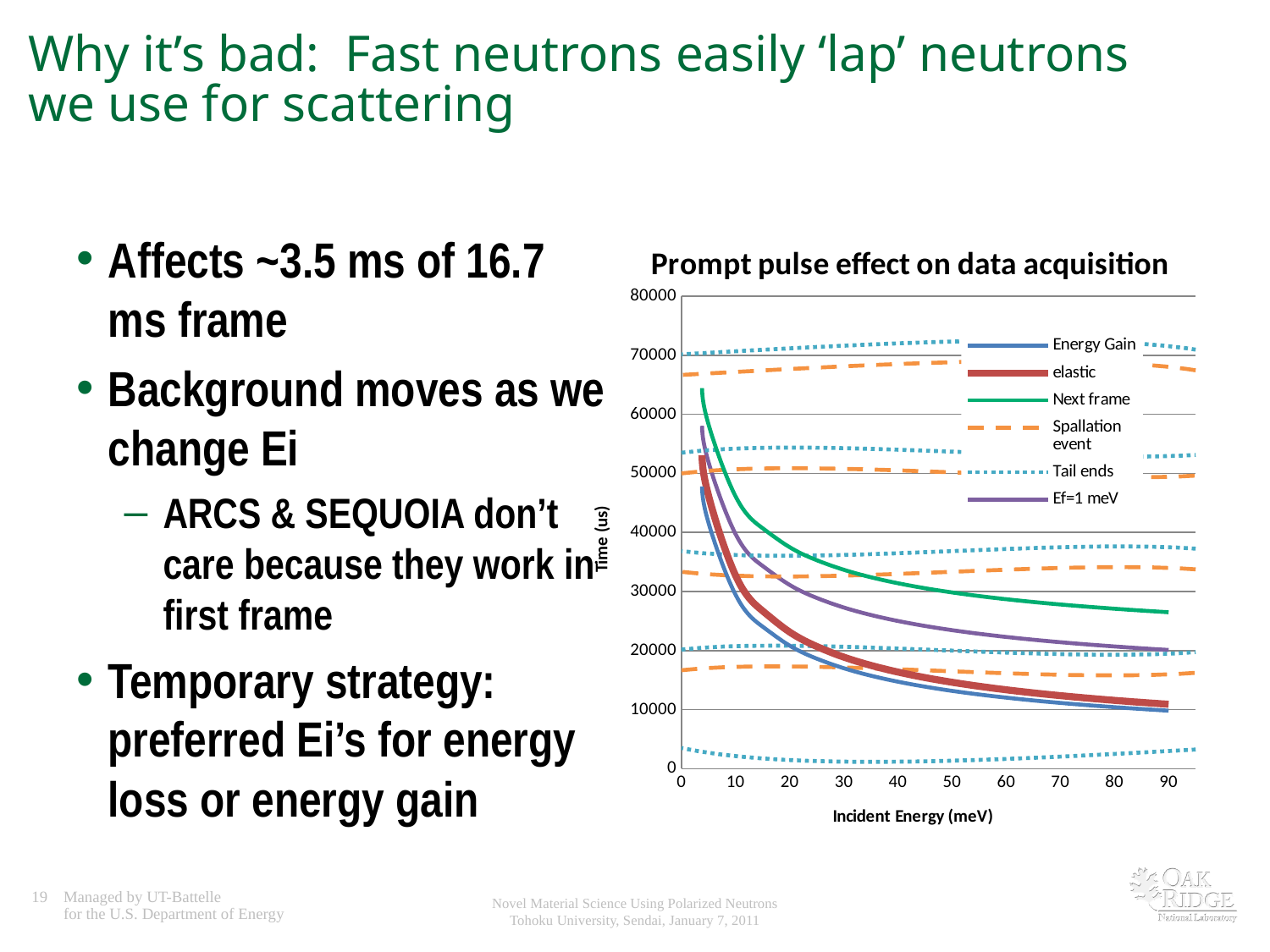
What kind of chart is shown on the slide? Line chart What is the title of the chart? Prompt pulse effect on data acquisition At 90 meV, which is larger: the 'Next frame' curve or the 'elastic' curve? Next frame Is the value of the 'elastic' curve at 30 meV greater or less than 20000? less Does the 'Next frame' curve rise or fall as incident energy increases? Fall Does the 'elastic' curve rise or fall as incident energy increases from 10 to 90 meV? Fall Is the value of the 'Next frame' curve at 90 meV greater or less than 30000? less Is the value of the 'Next frame' curve at 20 meV greater or less than 40000? less At 50 meV, which is larger: the 'Ef=1 meV' curve or the 'Energy Gain' curve? Ef=1 meV How many series does the chart legend list? 6 What is the label of the x axis of the chart? Incident Energy (meV)